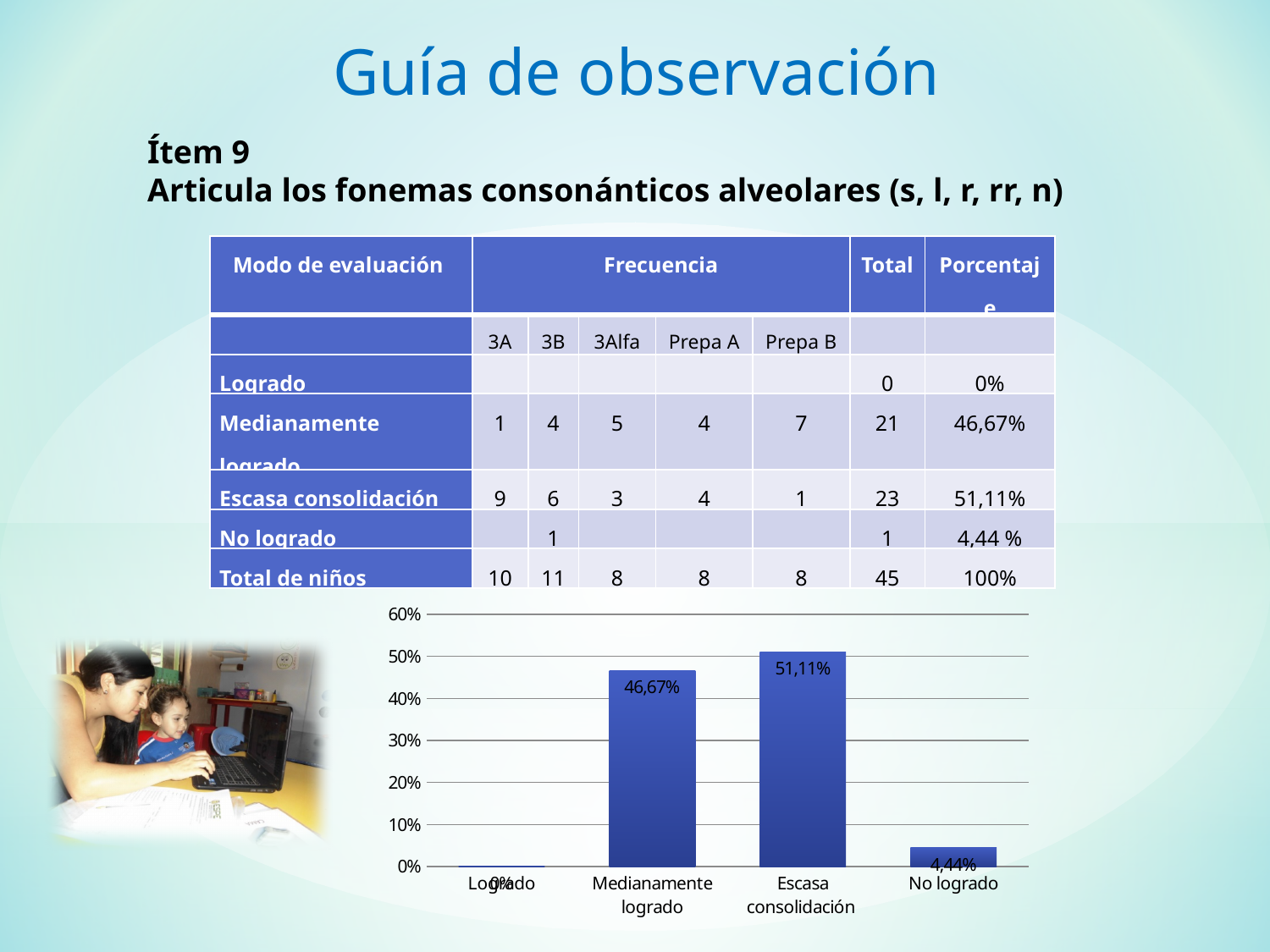
Which category has the highest value? Escasa consolidación Which category has the lowest value? Logrado What is the highest value shown on the y axis of the chart? 60% Which is larger, the value for Medianamente logrado or the value for No logrado? Medianamente logrado What is the value for Escasa consolidación? 51,11% What is the value for Logrado? 0% What is the value for No logrado? 4,44% What kind of chart is shown on the slide? bar chart What is the difference between the values for Escasa consolidación and Medianamente logrado? 4,44% What is the value for Medianamente logrado? 46,67% Is the value for Escasa consolidación greater or less than 50%? greater How many categories are plotted on the x axis of the chart? 4